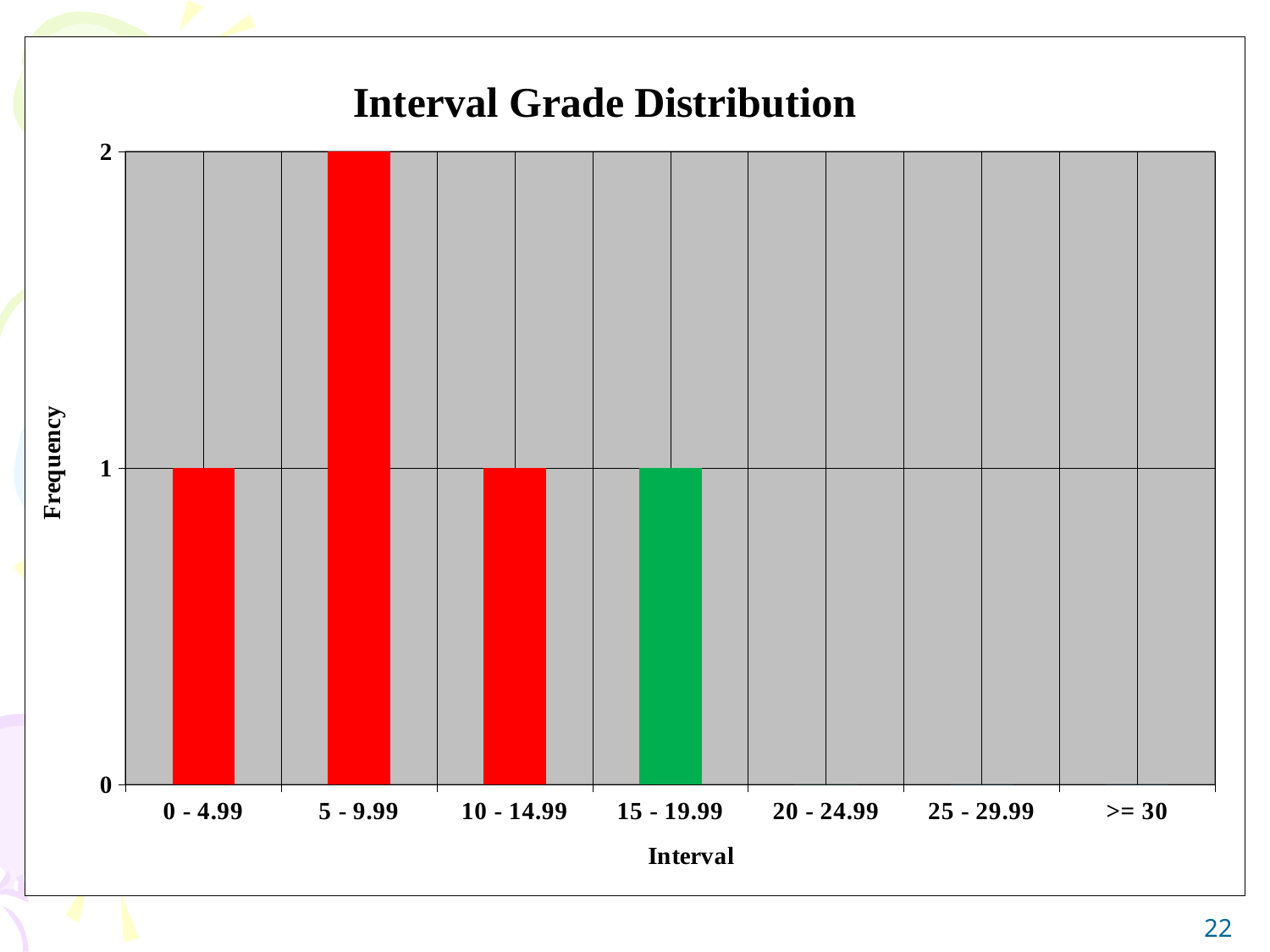
What is the frequency for the >= 30 interval? 0 What is the title of the chart? Interval Grade Distribution What is the frequency for the 20 - 24.99 interval? 0 What is the frequency for the 5 - 9.99 interval? 2 How many intervals are shown on the x axis? 7 What type of chart is shown on the slide? bar chart Which interval has the highest frequency? 5 - 9.99 What is the frequency for the 15 - 19.99 interval? 1 What is the frequency for the 0 - 4.99 interval? 1 What is the difference in frequency between the 5 - 9.99 interval and the 10 - 14.99 interval? 1 Which has a higher frequency, the 5 - 9.99 interval or the 0 - 4.99 interval? 5 - 9.99 What is the label of the y axis? Frequency